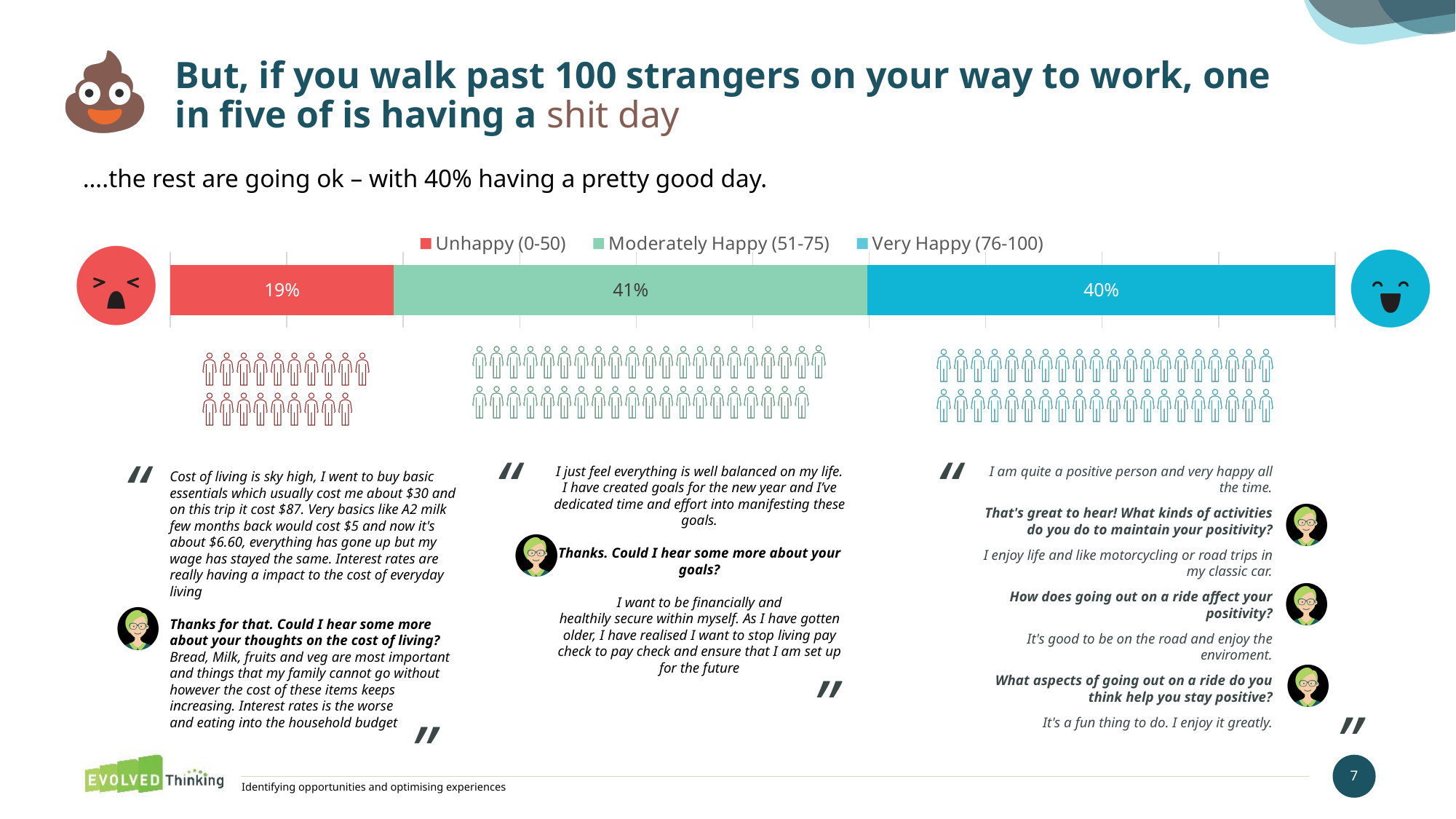
Which is larger, the Very Happy (76-100) segment or the Unhappy (0-50) segment? Very Happy (76-100) How many series does the legend list? 3 What colour is the Unhappy (0-50) segment of the bar? Red What value is shown for the Moderately Happy (51-75) segment? 41% What is the difference between the Very Happy (76-100) and Unhappy (0-50) values? 21% What kind of chart is shown on the slide? Stacked bar chart What value is shown for the Very Happy (76-100) segment? 40% Which segment of the bar has the largest value? Moderately Happy (51-75) What percentage of the stacked bar is labelled Unhappy (0-50)? 19% What is the total of the three segments in the stacked bar? 100% Which segment of the bar has the smallest value? Unhappy (0-50) What is the difference between the Moderately Happy (51-75) and Unhappy (0-50) values? 22%